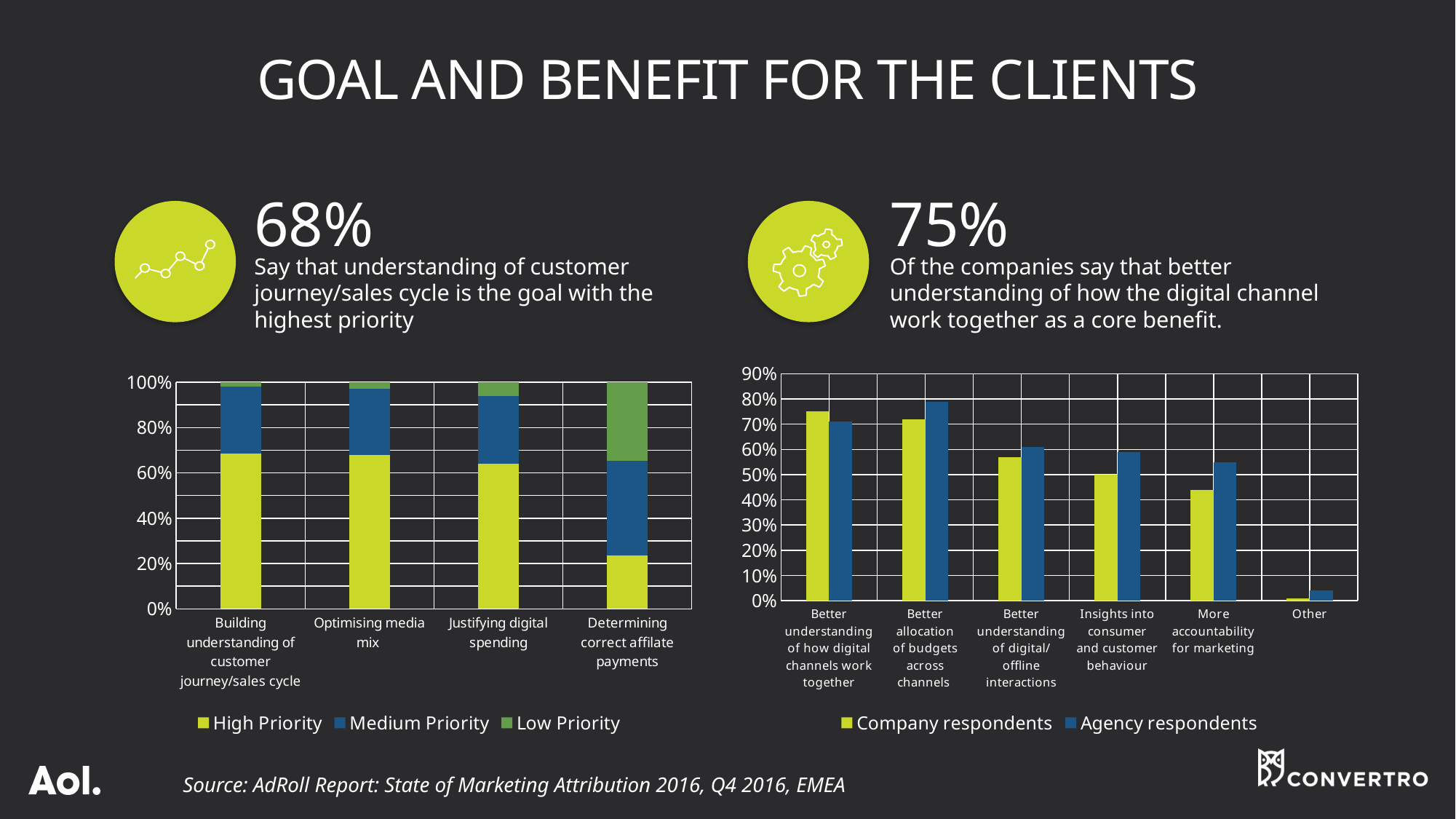
How many categories are shown on the x axis of the chart on the right of the slide? 6 In the chart on the left of the slide, which category has the smallest High Priority segment? Determining correct affilate payments In the chart on the right of the slide, which category has the lowest Company respondents value? Other In the chart on the left of the slide, what is the total of the stacked bar for Optimising media mix? 100% What type of chart is the chart on the left of the slide? Stacked bar chart In the chart on the left of the slide, which category has the largest Low Priority segment? Determining correct affilate payments In the chart on the right of the slide, which category has the highest Agency respondents value? Better allocation of budgets across channels How many series does the legend of the chart on the left of the slide list? 3 How many series does the legend of the chart on the right of the slide list? 2 In the chart on the right of the slide, for Insights into consumer and customer behaviour, which is larger: Company respondents or Agency respondents? Agency respondents In the chart on the right of the slide, is the Company respondents value for More accountability for marketing greater or less than 40%? greater In the chart on the left of the slide, is the High Priority value for Determining correct affilate payments greater or less than 40%? less